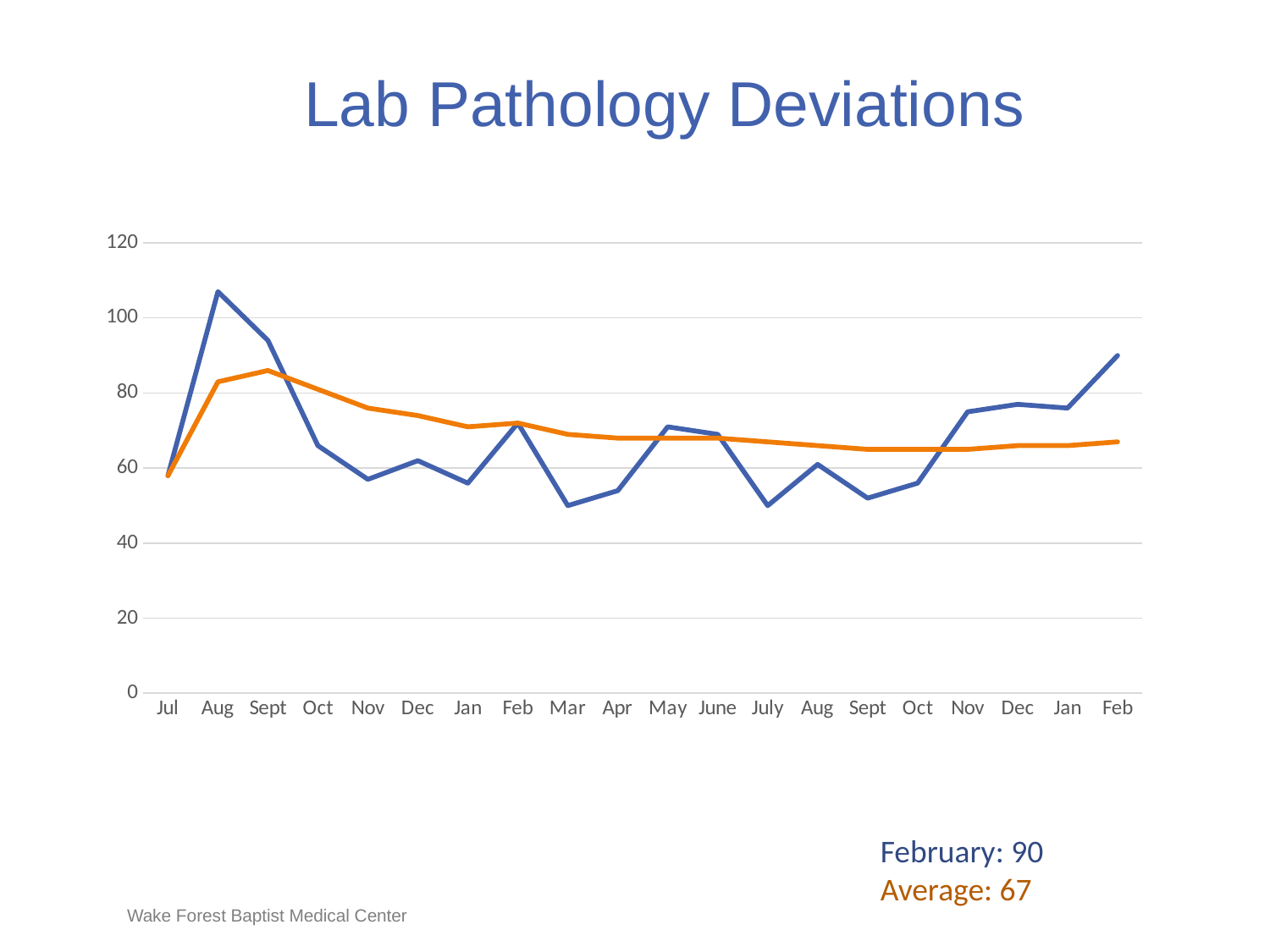
What is the title of the chart? Lab Pathology Deviations How many lines are plotted on the chart? 2 Is the value of the blue line for the first Aug greater or less than 100? greater How many months are labelled along the x axis of the chart? 20 Is the value of the blue line for Mar greater or less than 60? less Is the value of the blue line for the first Oct greater or less than 80? less Between the first Aug and the first Oct, does the blue line rise or fall? fall What is the value of the blue line for the final February on the chart? 90 What is the average value shown for the orange line at the end of the chart? 67 Which has the larger value on the blue line, Mar or May? May In which month does the blue line reach its highest value? Aug What kind of chart is shown on the slide? line chart